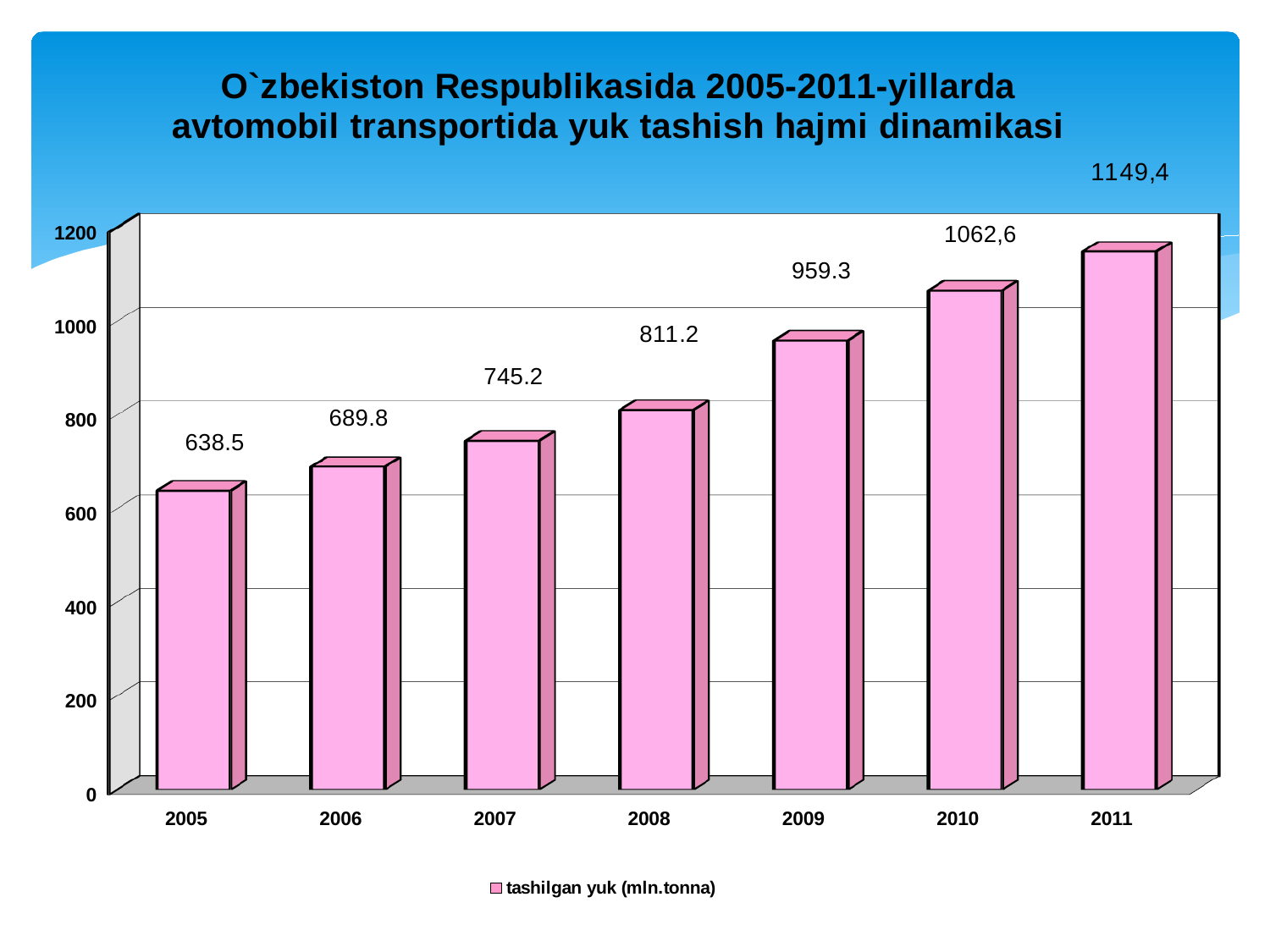
How many years are shown on the x axis? 7 What is the difference between the values for 2008 and 2007? 66.0 Which year has the highest value? 2011 Which year has the lowest value? 2005 Which is larger, the value for 2006 or the value for 2009? 2009 What is the value for 2010? 1062,6 Do the values rise or fall from 2005 to 2011? rise What is the value for 2005? 638.5 What is the value for 2008? 811.2 What is the value for 2011? 1149,4 What kind of chart is shown on the slide? bar chart What is the difference between the values for 2009 and 2008? 148.1